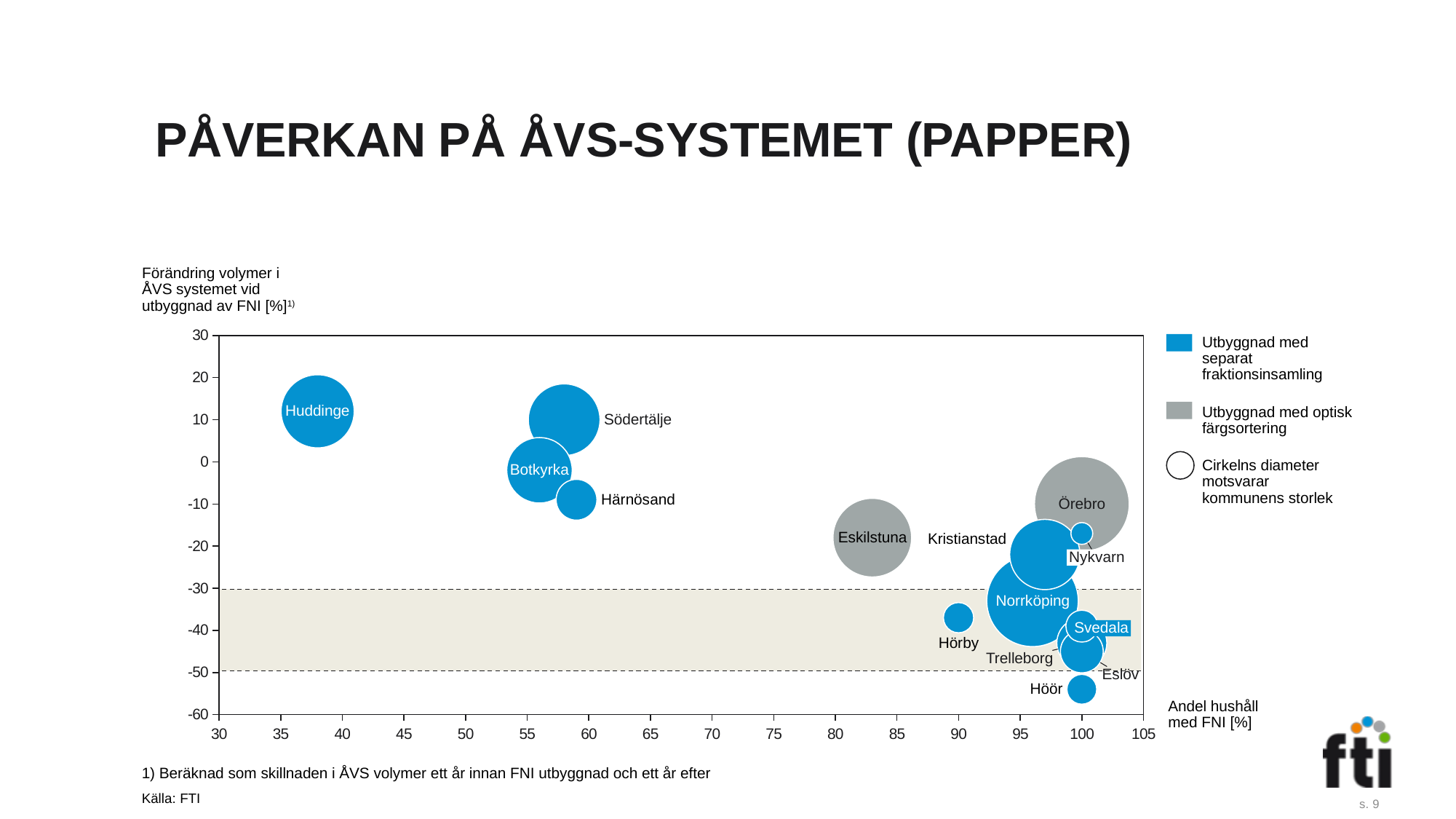
Is the vertical-axis value for Huddinge greater or less than 0? greater What kind of chart is shown on the slide? bubble chart According to the legend, what do the grey bubbles represent? Utbyggnad med optisk färgsortering Is the horizontal-axis value for Eskilstuna greater or less than 85? less Is the vertical-axis value for Höör greater or less than -50? less How many series does the legend list for the bubble colours? 2 Which has the larger vertical-axis value, Huddinge or Höör? Huddinge Which municipality has the lowest value on the horizontal axis (Andel hushåll med FNI)? Huddinge How many municipalities (bubbles) are plotted on the chart? 14 Which has the larger horizontal-axis value, Eskilstuna or Hörby? Hörby Which municipality has the lowest value on the vertical axis (Förändring volymer i ÅVS systemet)? Höör